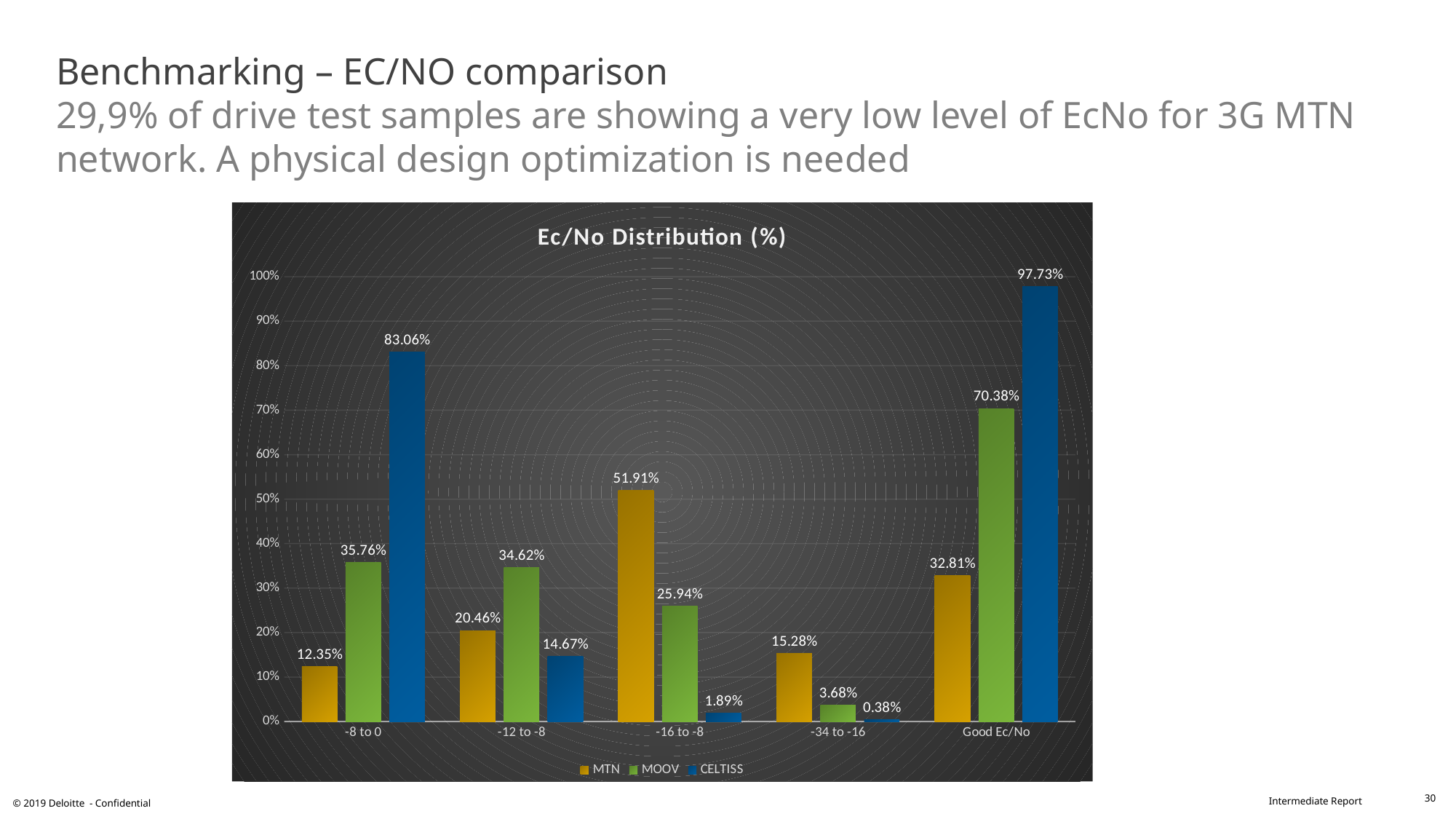
How many categories are shown on the x axis? 5 What is the value for CELTISS in the -8 to 0 category? 83.06% Is the value for MTN in the Good Ec/No category greater or less than 40%? less How many series does the legend list? 3 Which series has the lowest value in the -34 to -16 category? CELTISS Which series has the highest value in the Good Ec/No category? CELTISS Which is larger in the -12 to -8 category, MTN or MOOV? MOOV What is the value for MOOV in the Good Ec/No category? 70.38% What kind of chart is shown on the slide? bar chart What is the difference between the MTN and MOOV values in the -16 to -8 category? 25.97% What is the title of the chart? Ec/No Distribution (%) What is the value for MTN in the -16 to -8 category? 51.91%